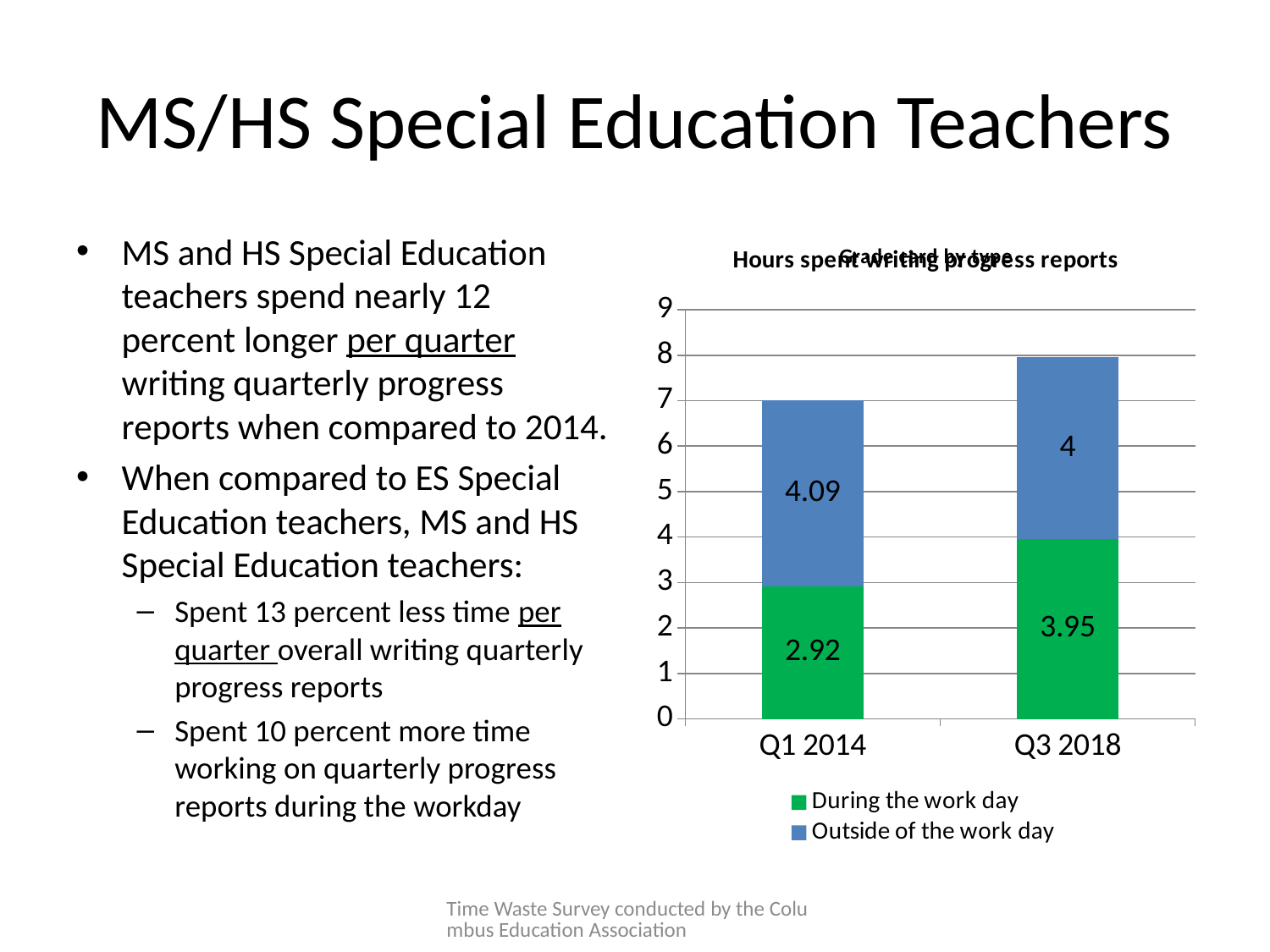
How many hours were spent outside of the work day in Q1 2014? 4.09 How many categories are shown on the x axis? 2 Which period has the larger value for hours spent during the work day, Q1 2014 or Q3 2018? Q3 2018 How many series does the legend list? 2 How many hours were spent during the work day in Q1 2014? 2.92 Which series is shown in green? During the work day What is the difference between the hours spent during the work day in Q3 2018 and in Q1 2014? 1.03 What kind of chart is shown on the slide? Stacked bar chart How many hours were spent outside of the work day in Q3 2018? 4 How many hours were spent during the work day in Q3 2018? 3.95 What is the total number of hours for the Q1 2014 bar? 7.01 What is the total number of hours for the Q3 2018 bar? 7.95